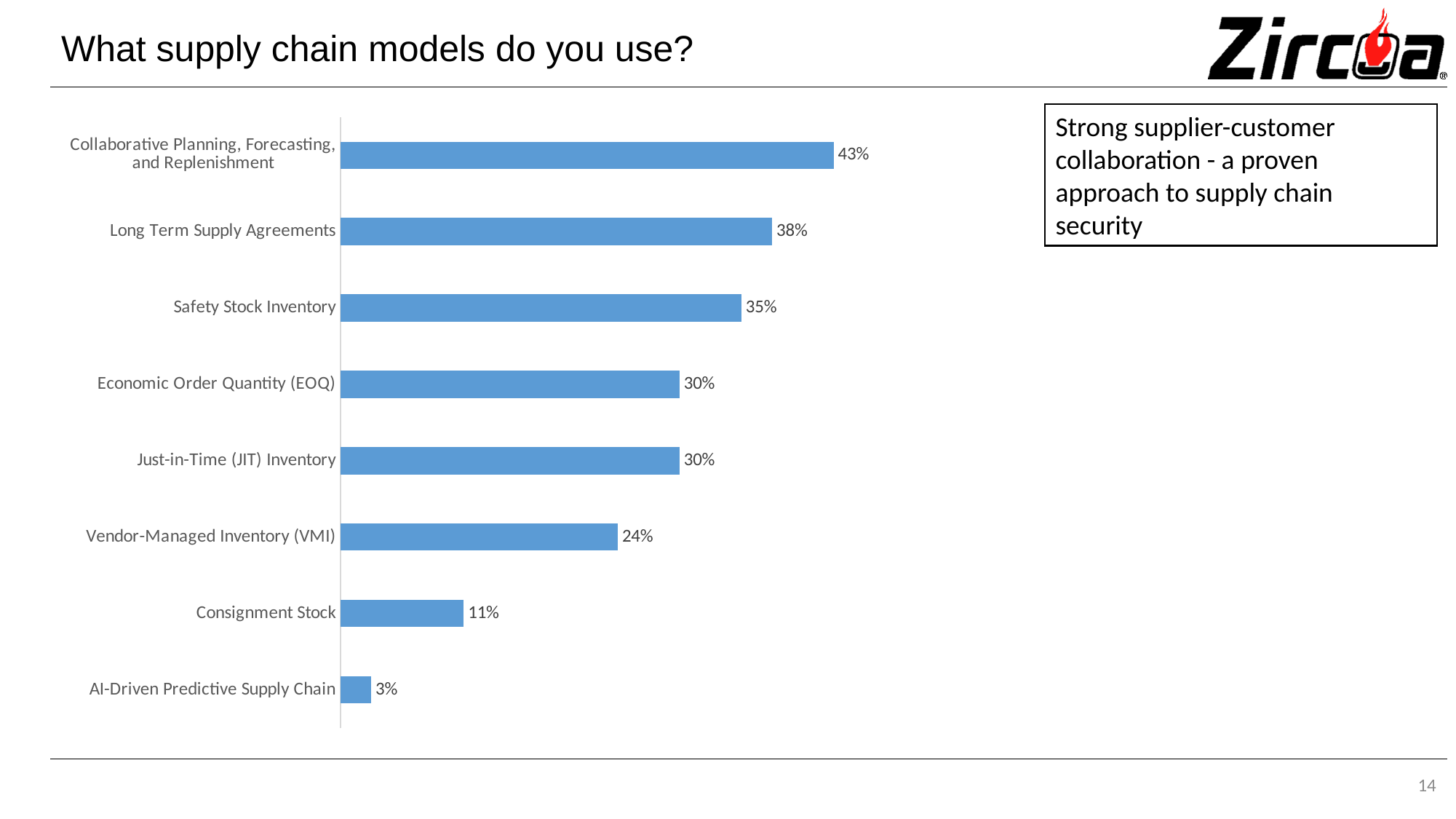
How many supply chain models are shown in the chart? 8 Which supply chain model has the lowest value? AI-Driven Predictive Supply Chain What is the difference between the values for Collaborative Planning, Forecasting, and Replenishment and Long Term Supply Agreements? 5% What is the value for Safety Stock Inventory? 35% What is the difference between the values for Vendor-Managed Inventory (VMI) and Consignment Stock? 13% Which supply chain model has the highest value? Collaborative Planning, Forecasting, and Replenishment What is the value for Vendor-Managed Inventory (VMI)? 24% Which is larger, the value for Safety Stock Inventory or the value for Economic Order Quantity (EOQ)? Safety Stock Inventory What is the title of the slide containing the chart? What supply chain models do you use? What percentage of respondents use Long Term Supply Agreements? 38% What kind of chart is shown on the slide? Bar chart What is the value for AI-Driven Predictive Supply Chain? 3%